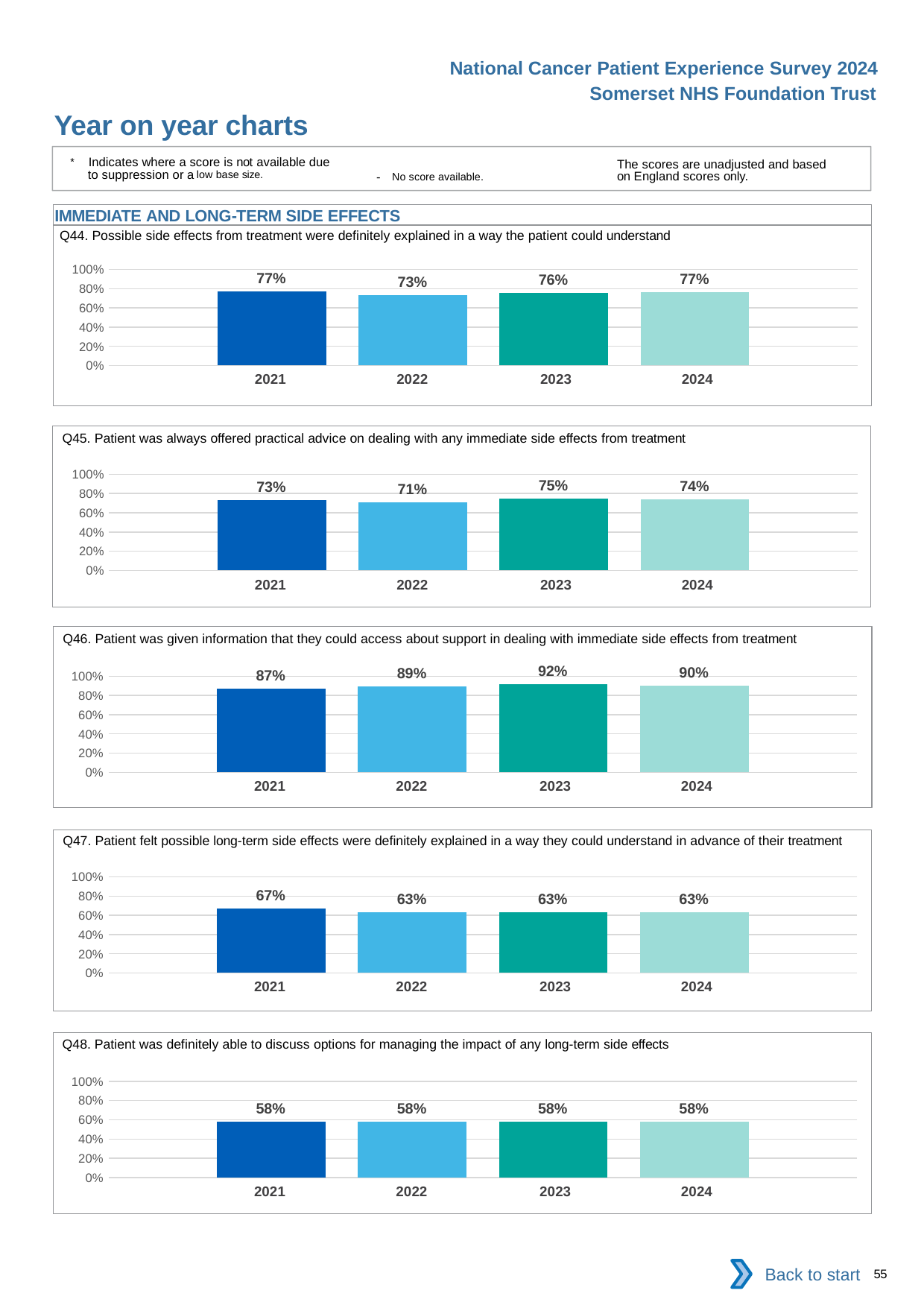
In the Q48 chart, how many years are plotted? 4 In the Q45 chart, which year has the lowest value? 2022 In the Q44 chart, what is the value for 2022? 73% In the Q47 chart, what is the value for 2023? 63% In the Q48 chart, what is the value for 2021? 58% In the Q48 chart, do the values rise, fall or stay the same from 2021 to 2024? stay the same In the Q44 chart, what is the difference between the 2021 and 2022 values? 4% What kind of chart is the Q44 chart? bar chart In the Q47 chart, which is larger, the value for 2021 or the value for 2022? 2021 In the Q46 chart, what is the difference between the 2023 and 2021 values? 5% In the Q45 chart, which year has the highest value? 2023 In the Q46 chart, what is the value for 2024? 90%